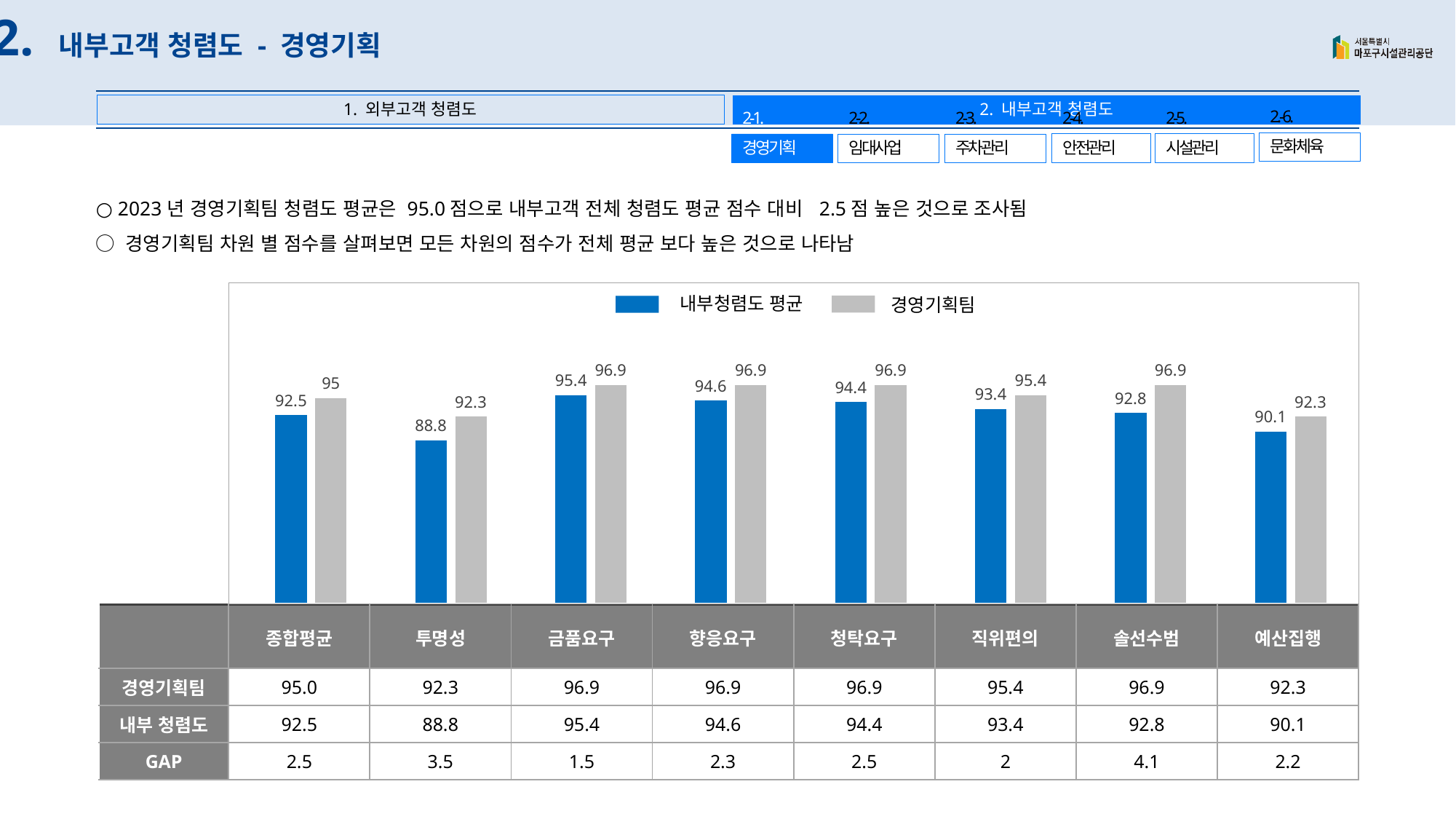
What is the 내부청렴도 평균 value for 예산집행? 90.1 Which category has the lowest 내부청렴도 평균 value? 투명성 What is the 내부청렴도 평균 value for 투명성? 88.8 How many categories are plotted on the chart? 8 What kind of chart is shown on the slide? bar chart Which category has the highest 내부청렴도 평균 value? 금품요구 What is the 경영기획팀 value for 직위편의? 95.4 How many series does the chart legend list? 2 What is the difference between the 경영기획팀 and 내부청렴도 평균 values for 솔선수범? 4.1 What is the 경영기획팀 value for 종합평균 as labelled on the chart? 95 Which is larger for 청탁요구: the 내부청렴도 평균 value or the 경영기획팀 value? 경영기획팀 Which series is shown in gray in the chart? 경영기획팀